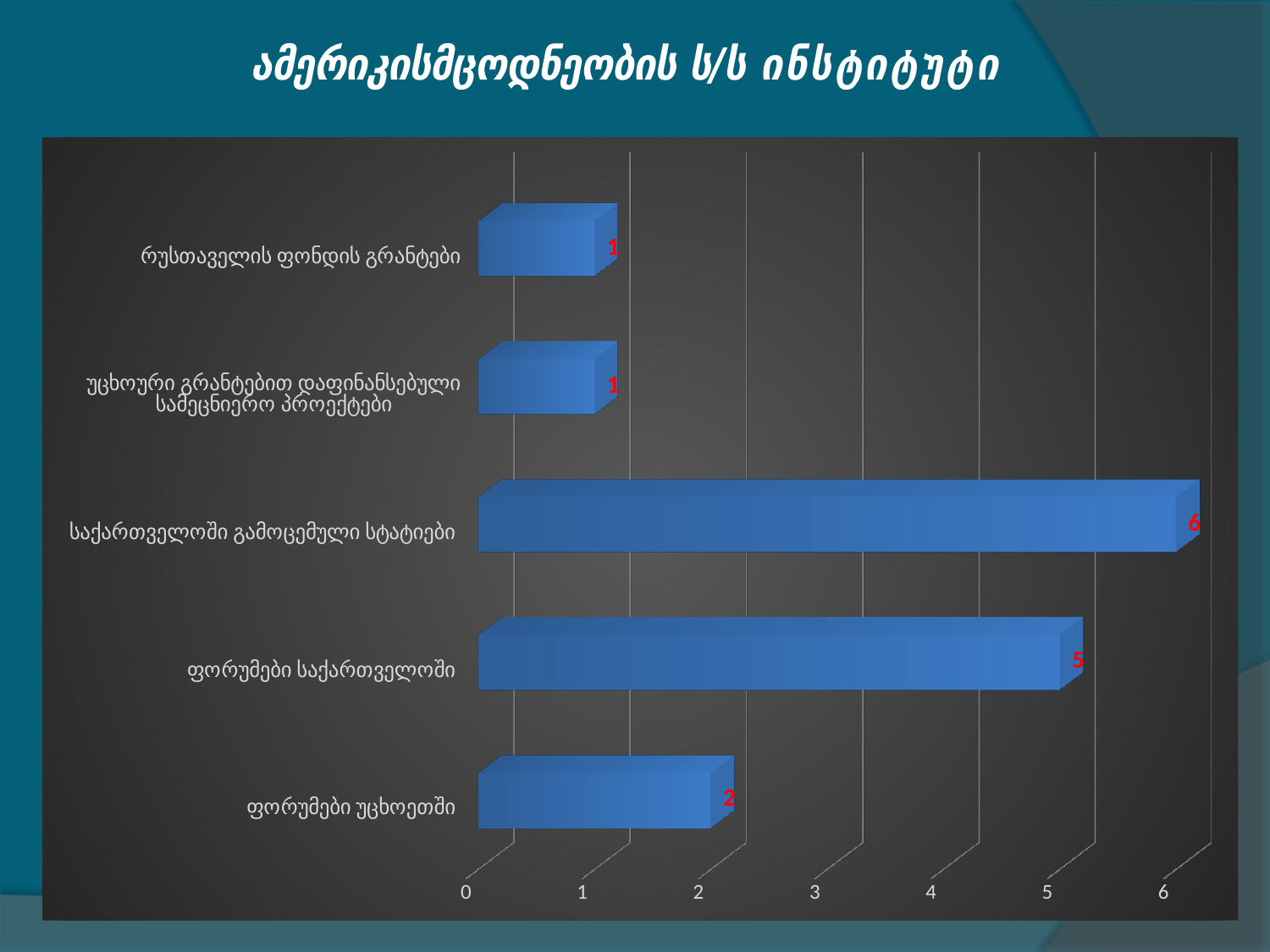
What type of chart is shown on the slide? bar chart What is the value for ფორუმები უცხოეთში? 2 How many categories are plotted in the chart? 5 Which category has the highest value? საქართველოში გამოცემული სტატიები What is the highest value shown on the horizontal axis? 6 What is the value for ფორუმები საქართველოში? 5 Which is larger: the value for ფორუმები უცხოეთში or the value for უცხოური გრანტებით დაფინანსებული სამეცნიერო პროექტები? ფორუმები უცხოეთში What is the difference between the values for ფორუმები საქართველოში and ფორუმები უცხოეთში? 3 What is the difference between the values for საქართველოში გამოცემული სტატიები and ფორუმები საქართველოში? 1 What is the title of the slide? ამერიკისმცოდნეობის ს/ს ინსტიტუტი What is the value for რუსთაველის ფონდის გრანტები? 1 What is the value for საქართველოში გამოცემული სტატიები? 6